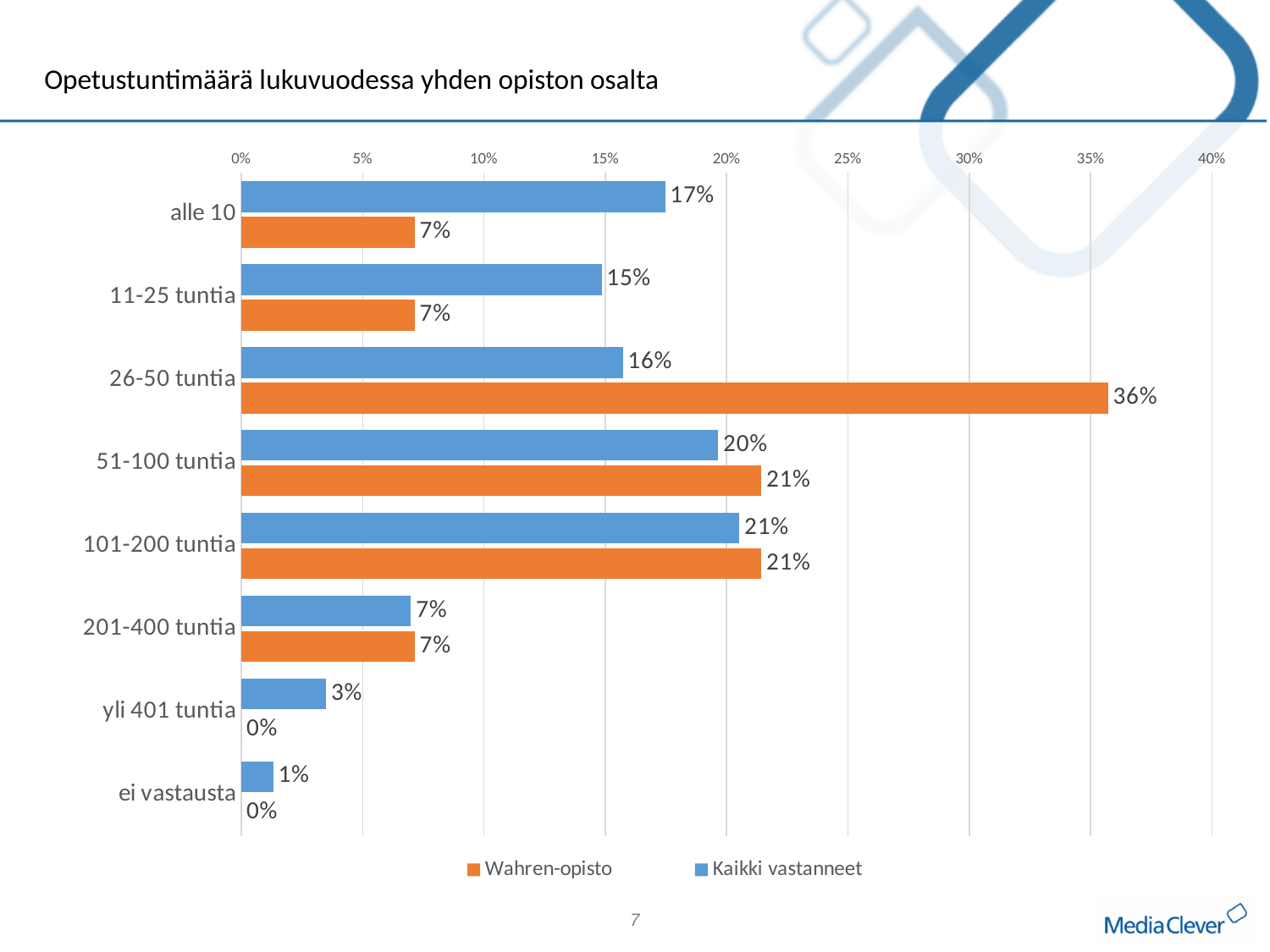
What is the value for Kaikki vastanneet in the alle 10 category? 17% What is the value for Wahren-opisto in the yli 401 tuntia category? 0% In the alle 10 category, which series has the larger value, Wahren-opisto or Kaikki vastanneet? Kaikki vastanneet What is the difference between the Wahren-opisto and Kaikki vastanneet values in the 26-50 tuntia category? 20% How many categories are shown on the chart? 8 What is the value for Wahren-opisto in the 26-50 tuntia category? 36% What is the value for Kaikki vastanneet in the 51-100 tuntia category? 20% How many series does the legend list? 2 Which category has the highest value for Wahren-opisto? 26-50 tuntia What kind of chart is shown on the slide? Bar chart Which colour represents Wahren-opisto in the chart? Orange Which category has the lowest value for Kaikki vastanneet? ei vastausta